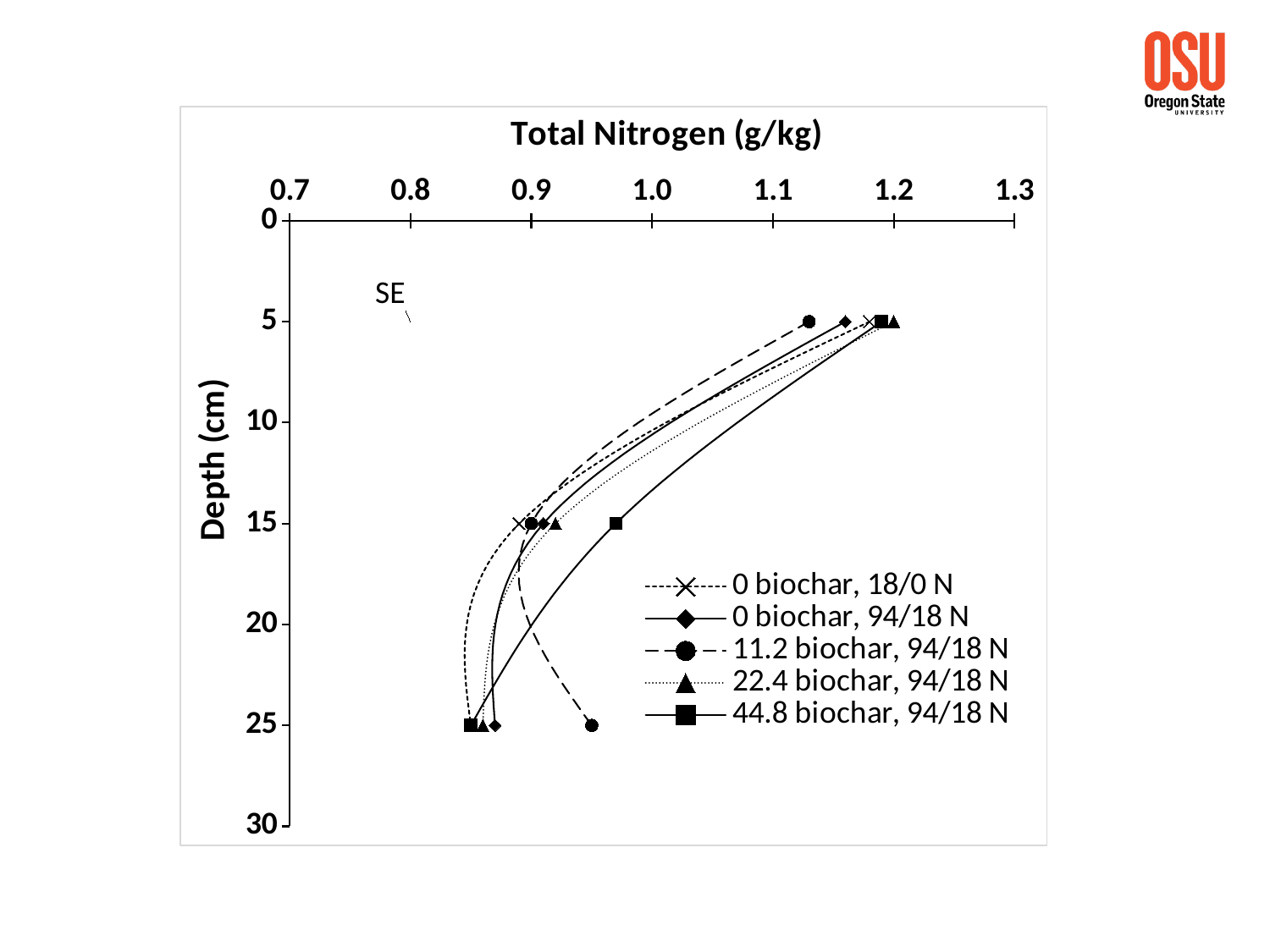
At 25 cm depth, which series has the highest total nitrogen? 11.2 biochar, 94/18 N Is the total nitrogen for 44.8 biochar, 94/18 N at 15 cm depth greater or less than 0.9? greater At 5 cm depth, which has the larger total nitrogen: 11.2 biochar, 94/18 N or 44.8 biochar, 94/18 N? 44.8 biochar, 94/18 N Is the total nitrogen for 11.2 biochar, 94/18 N at 25 cm depth greater or less than 0.9? greater Is the total nitrogen for 11.2 biochar, 94/18 N at 5 cm depth greater or less than 1.2? less How many series does the legend list? 5 What is the title of the horizontal axis? Total Nitrogen (g/kg) At 15 cm depth, which series has the highest total nitrogen? 44.8 biochar, 94/18 N At how many depths are data points plotted for each series? 3 For the 44.8 biochar, 94/18 N series, does total nitrogen increase or decrease as depth increases from 5 cm to 25 cm? decrease What is the label of the vertical axis? Depth (cm)